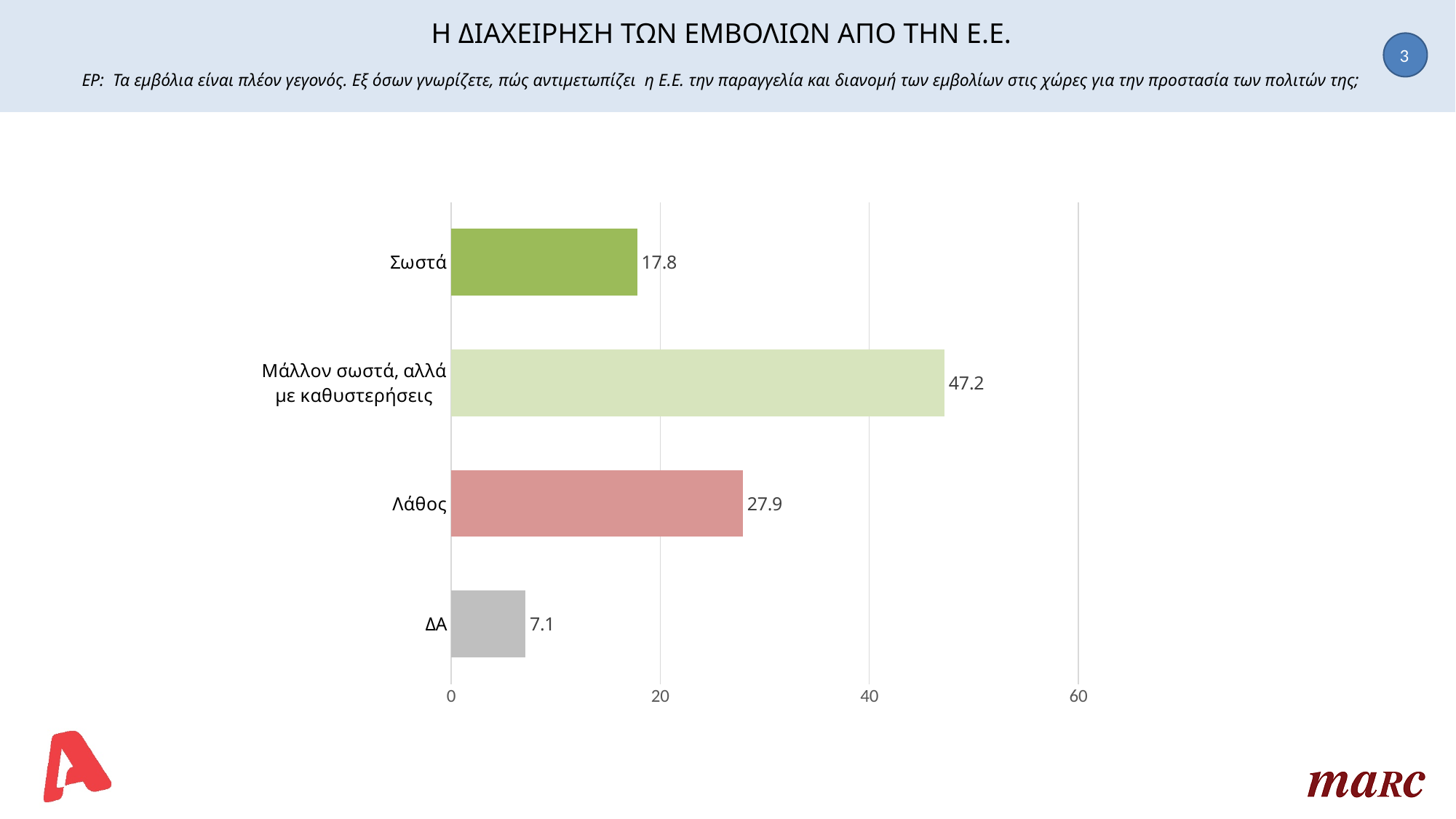
Which category has the highest value? Μάλλον σωστά, αλλά με καθυστερήσεις What is the difference between the values for Λάθος and Σωστά? 10.1 Which is larger, the value for Σωστά or the value for Λάθος? Λάθος Which category has the lowest value? ΔΑ How many categories are shown in the chart? 4 What is the difference between the values for Μάλλον σωστά, αλλά με καθυστερήσεις and Λάθος? 19.3 What is the value for ΔΑ? 7.1 What is the value for Σωστά? 17.8 Is the value for Μάλλον σωστά, αλλά με καθυστερήσεις greater or less than 40? greater What is the value for Μάλλον σωστά, αλλά με καθυστερήσεις? 47.2 What kind of chart is shown on the slide? bar chart What is the value for Λάθος? 27.9